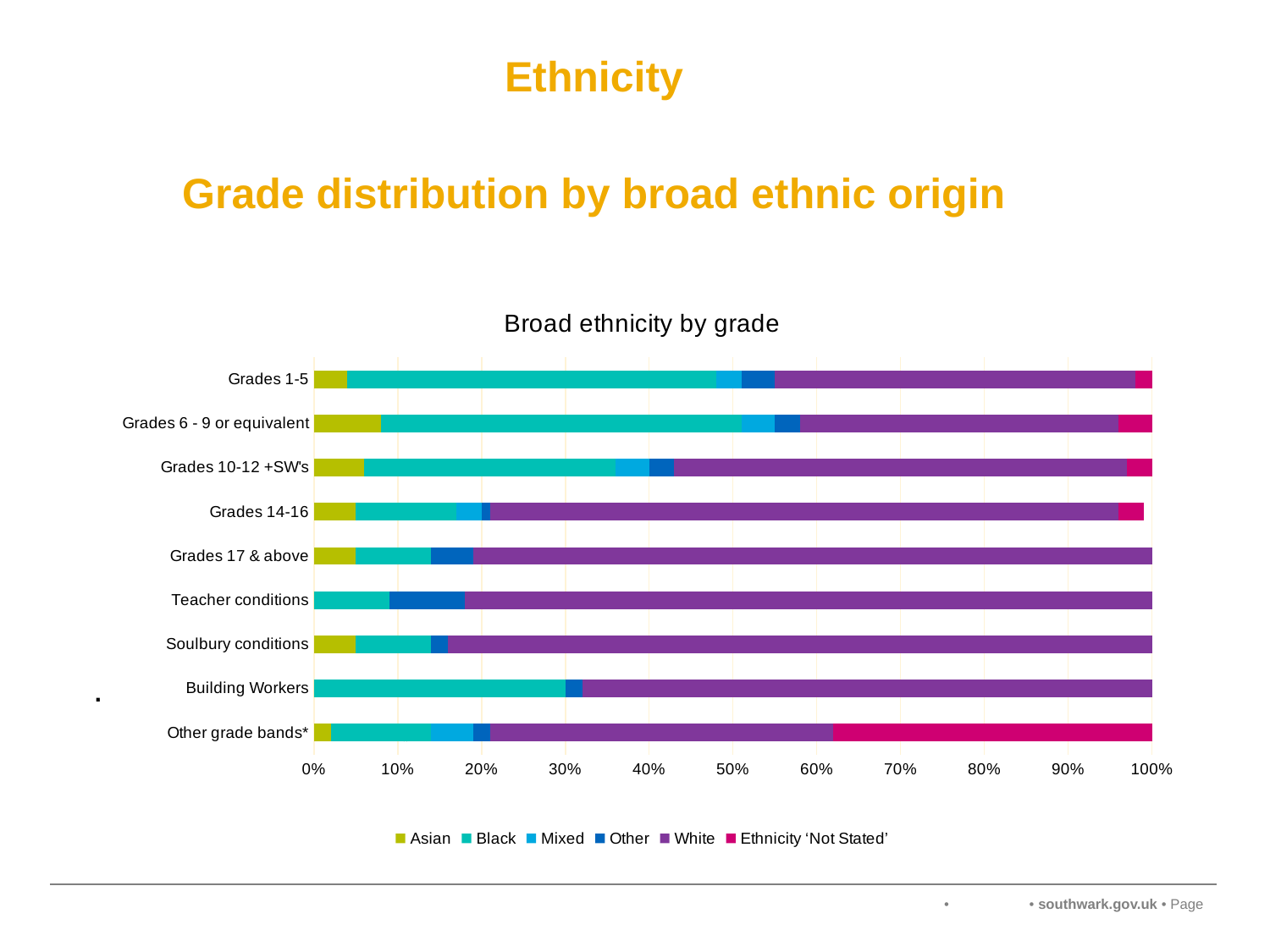
Which has the larger White share, Grades 17 & above or Grades 1-5? Grades 17 & above How many series does the legend list? 6 What is the title of the chart? Broad ethnicity by grade Is the White share for Building Workers greater or less than 60%? greater Which grade category has the largest Ethnicity 'Not Stated' share? Other grade bands* Is the Asian share for Grades 6 - 9 or equivalent greater or less than 10%? less Which has the larger Black share, Grades 1-5 or Grades 14-16? Grades 1-5 Is the Ethnicity 'Not Stated' share for Other grade bands* greater or less than 30%? greater What kind of chart is shown on the slide? bar chart Which series is listed last in the legend? Ethnicity 'Not Stated' How many grade categories are plotted on the chart? 9